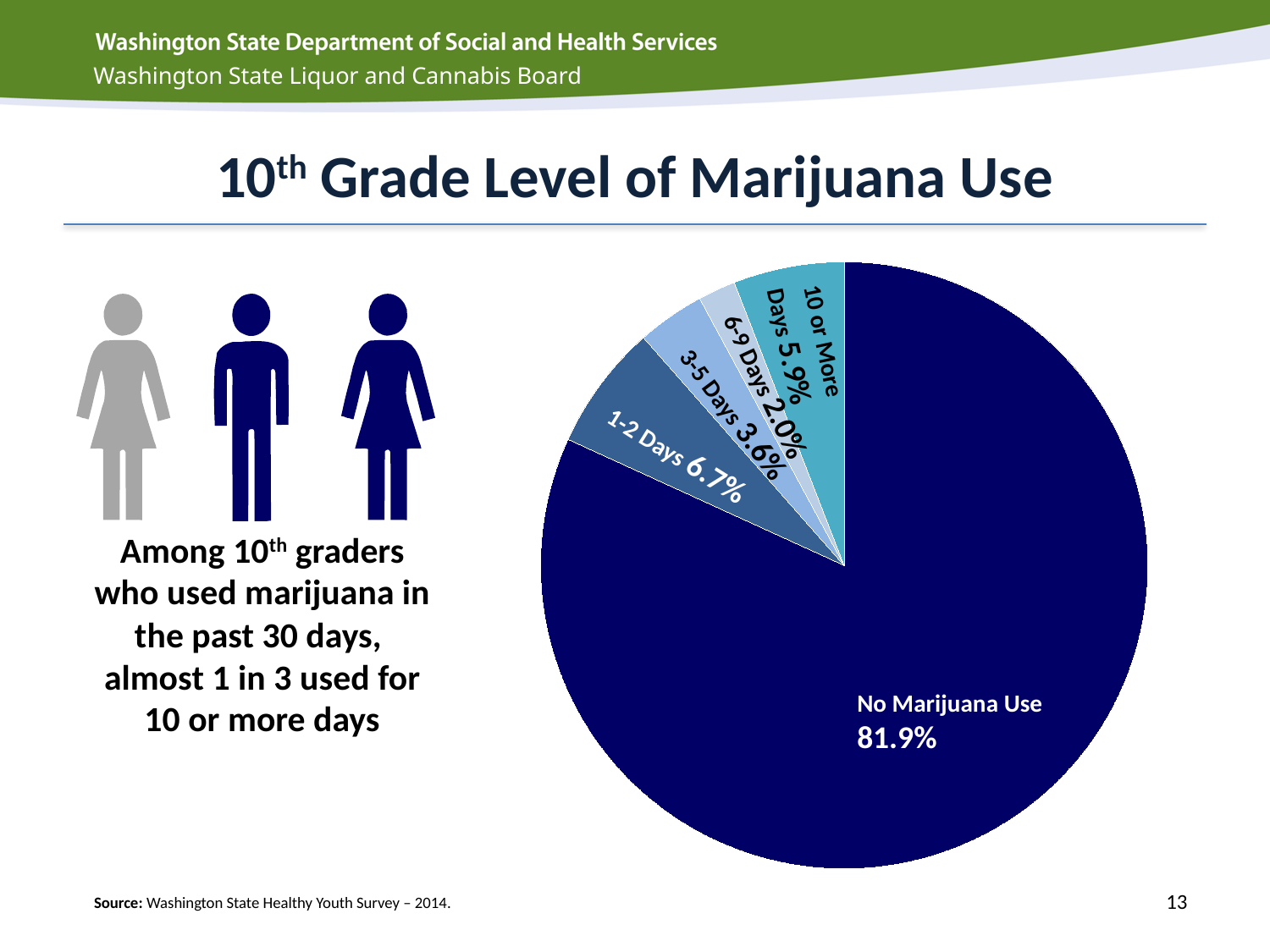
What kind of chart is shown on the slide? pie chart Which slice of the pie chart is the smallest? 6-9 Days What percentage of 10th graders used marijuana for 10 or More Days? 5.9% How many slices does the pie chart have? 5 What percentage of 10th graders reported No Marijuana Use? 81.9% What percentage of 10th graders used marijuana for 3-5 Days? 3.6% What percentage of 10th graders used marijuana for 1-2 Days? 6.7% What percentage of 10th graders used marijuana for 6-9 Days? 2.0% Which slice of the pie chart is the largest? No Marijuana Use What is the difference between the 1-2 Days share and the 3-5 Days share? 3.1% What is the title of the slide containing the pie chart? 10th Grade Level of Marijuana Use Which is larger, the share for 1-2 Days or the share for 10 or More Days? 1-2 Days